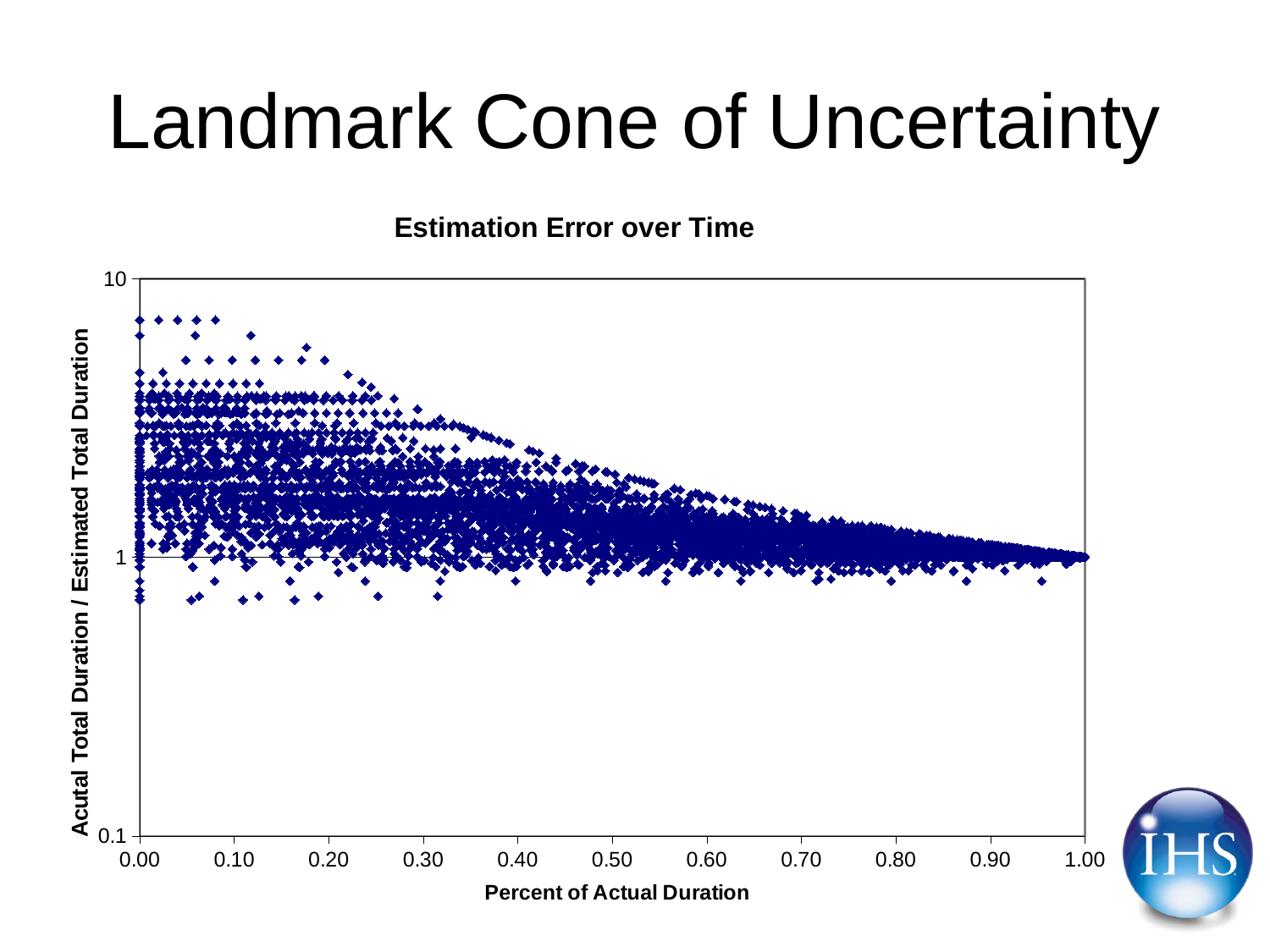
What is the largest tick value shown on the x axis? 1.00 What is the title of the chart? Estimation Error over Time What is the highest tick value shown on the y axis? 10 Is the lowest plotted point greater or less than 0.1 on the y axis? greater What is the label of the x axis? Percent of Actual Duration Are the points near a Percent of Actual Duration of 0.00 mostly greater or less than 1 on the y axis? greater Is the highest plotted point greater or less than 10 on the y axis? less Toward which y-axis value do the points converge at a Percent of Actual Duration of 1.00? 1 As Percent of Actual Duration increases toward 1.00, does the spread of the plotted points widen or narrow? narrow What kind of chart is shown on the slide? scatter chart